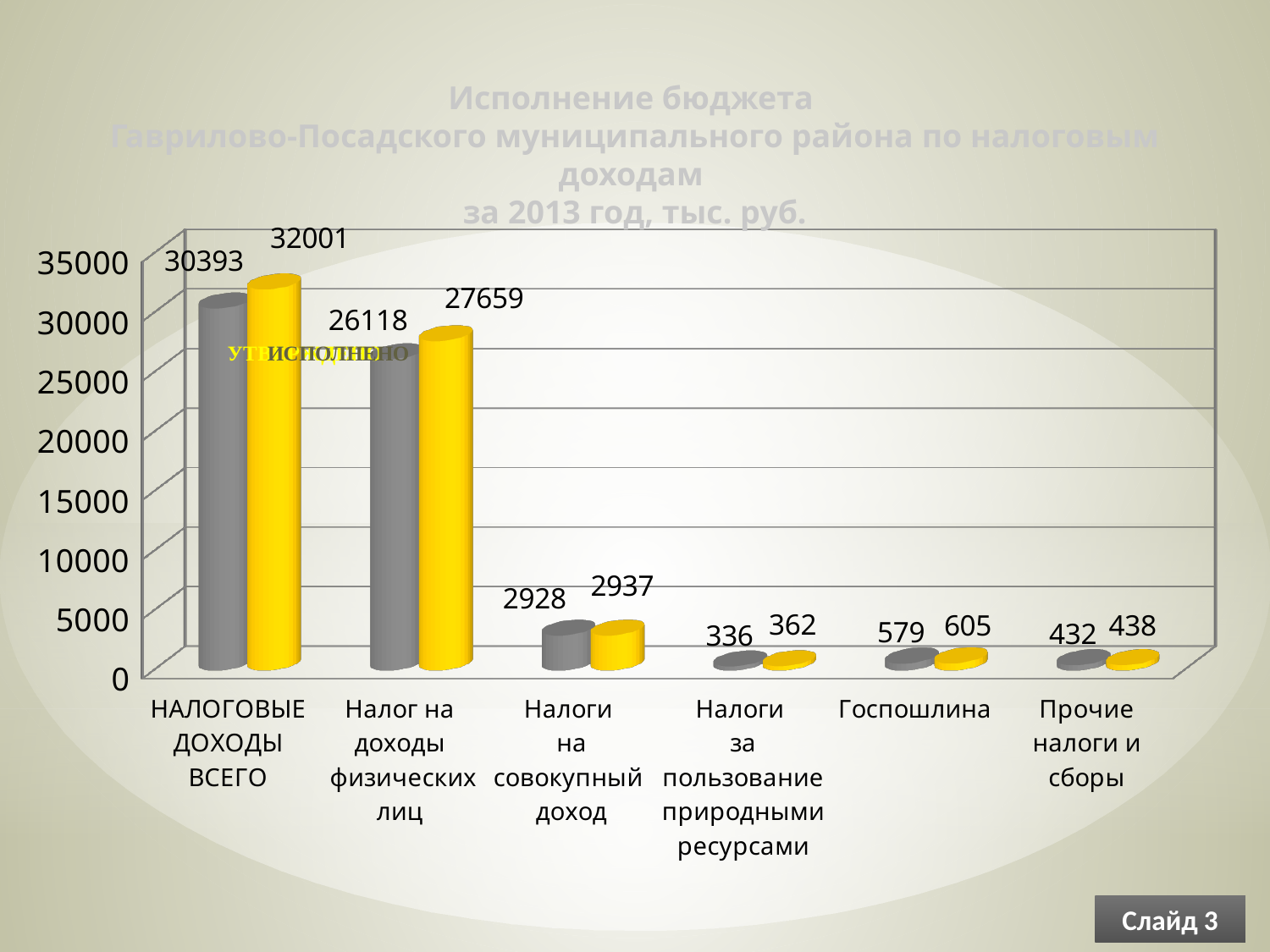
Which is larger: the grey bar for Госпошлина or the grey bar for Прочие налоги и сборы? Госпошлина What is the value of the yellow bar for Налоги за пользование природными ресурсами? 362 What is the value of the grey bar for Госпошлина? 579 Which category has the highest yellow bar value? НАЛОГОВЫЕ ДОХОДЫ ВСЕГО Which category has the lowest grey bar value? Налоги за пользование природными ресурсами What is the difference between the yellow and grey bars for Налог на доходы физических лиц? 1541 What is the value of the grey bar for НАЛОГОВЫЕ ДОХОДЫ ВСЕГО? 30393 How many series does the chart plot? 2 What is the value of the yellow bar for Налог на доходы физических лиц? 27659 How many categories are shown on the x axis? 6 What kind of chart is shown on the slide? Bar chart What is the difference between the yellow and grey bars for НАЛОГОВЫЕ ДОХОДЫ ВСЕГО? 1608